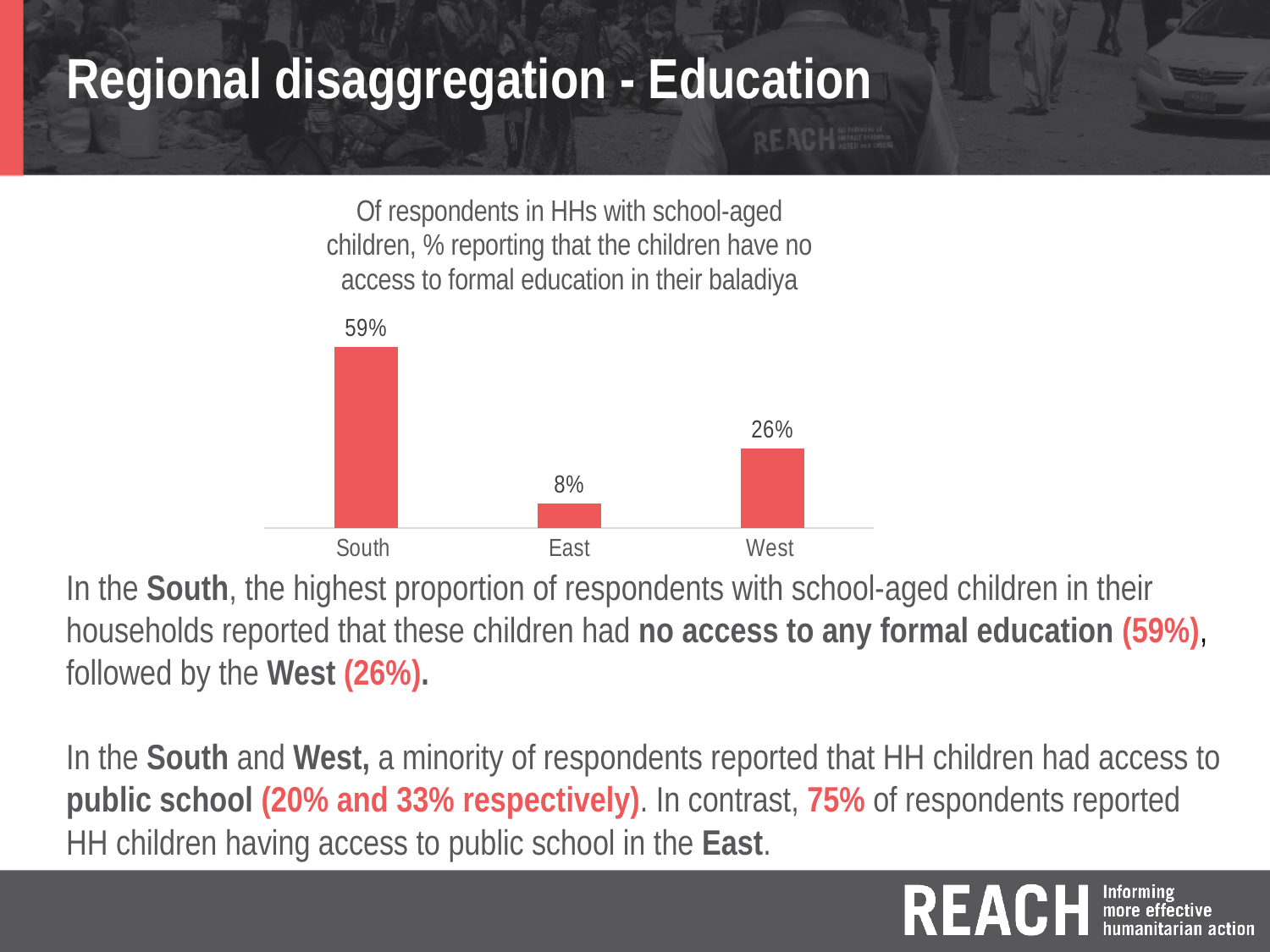
What percentage of respondents in the West reported that children have no access to formal education? 26% What is the title of the chart? Of respondents in HHs with school-aged children, % reporting that the children have no access to formal education in their baladiya Which region has a larger value, East or West? West Which region has the highest percentage reporting no access to formal education? South What is the difference in percentage points between the West and the East? 18 What colour are the bars in the chart? Red What is the difference in percentage points between the South and the West? 33 What percentage of respondents in the East reported that children have no access to formal education? 8% What percentage of respondents in the South reported that children have no access to formal education? 59% What type of chart is shown on the slide? Bar chart Which region has the lowest percentage reporting no access to formal education? East How many regions are shown in the chart? 3